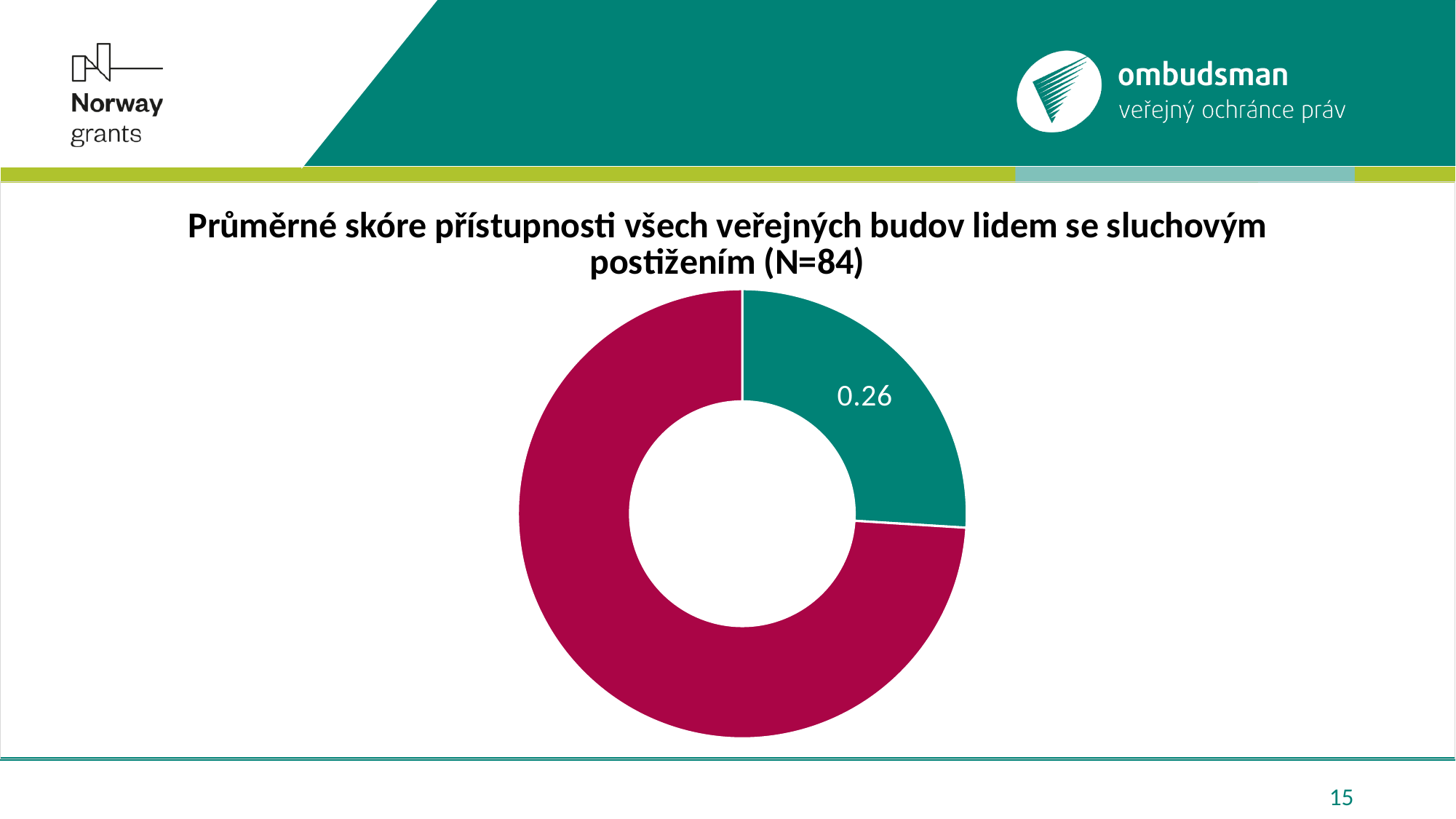
Which slice of the doughnut chart is larger, the teal one or the crimson (red) one? The crimson (red) one What is the title of the chart? Průměrné skóre přístupnosti všech veřejných budov lidem se sluchovým postižením (N=84) What kind of chart is shown on the slide? Doughnut (pie) chart What value is printed on the teal (green) slice of the doughnut chart? 0.26 What sample size (N) is stated in the chart title? 84 What share of the doughnut does the teal slice represent, according to its data label? 0.26 Is the teal slice of the doughnut chart more or less than half of the whole? less Which slice of the doughnut chart is the smallest? The teal slice (0.26) How many slices does the doughnut chart have? 2